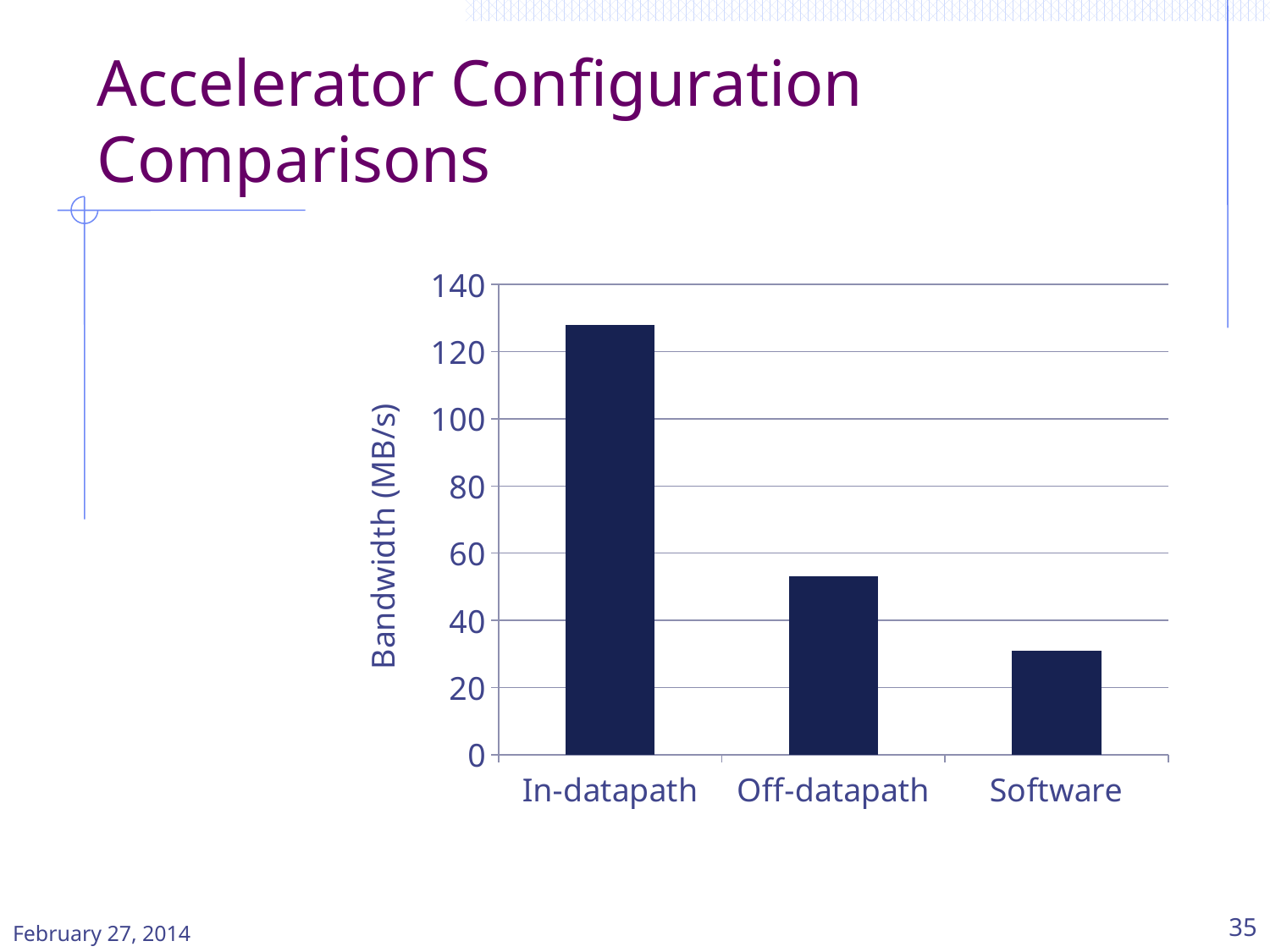
Is the bandwidth for Software greater or less than 40? less Is the bandwidth for Off-datapath greater or less than 60? less Which category has the lowest bandwidth? Software Is the bandwidth for In-datapath greater or less than 120? greater What kind of chart is shown on the slide? bar chart What is the label of the vertical axis? Bandwidth (MB/s) How many categories are shown on the x axis of the chart? 3 Do the bar values rise or fall from left to right along the x axis? fall What is the maximum value shown on the vertical axis? 140 Which category has the highest bandwidth? In-datapath Which has a higher bandwidth, Off-datapath or Software? Off-datapath